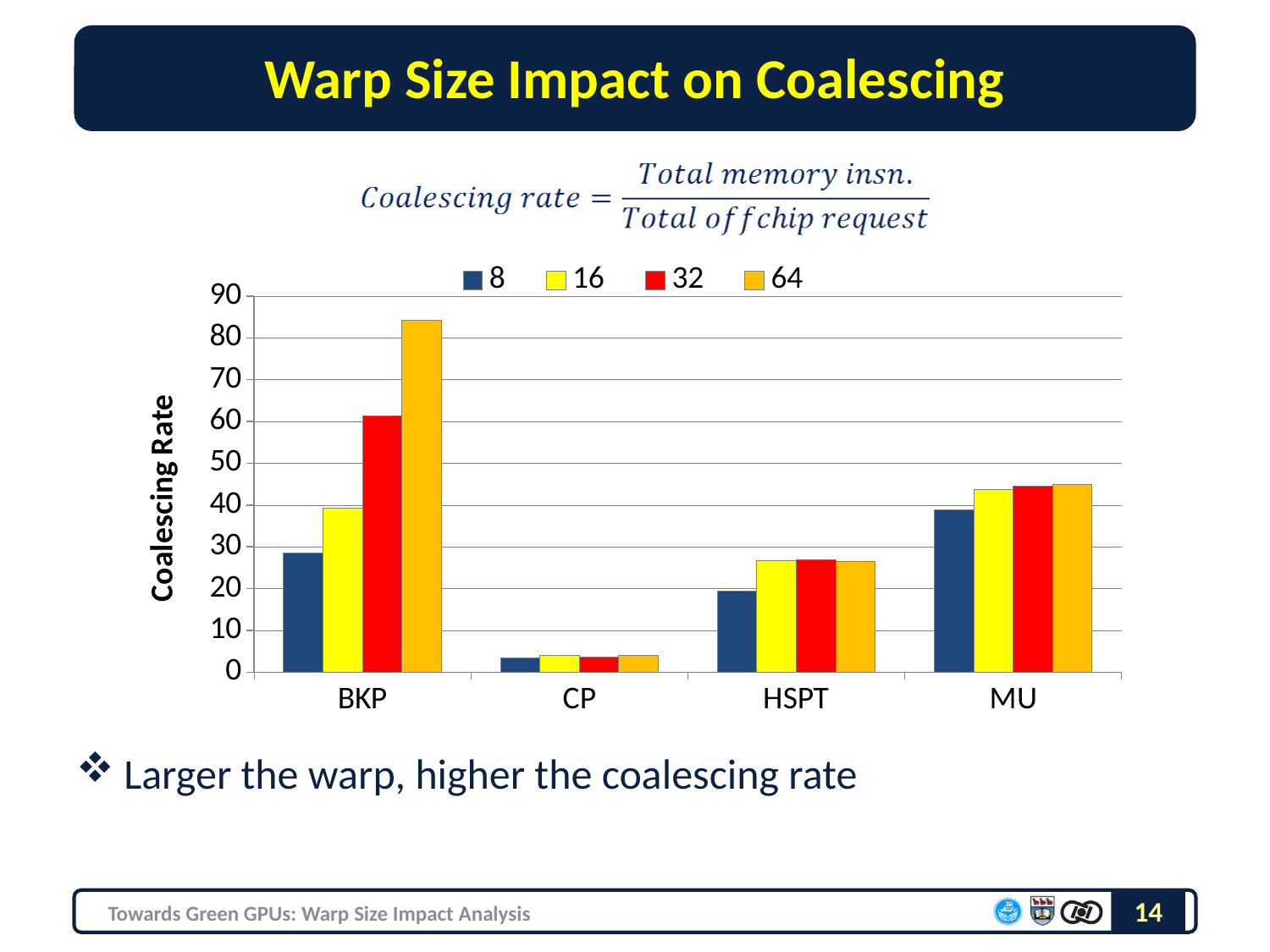
Is the coalescing rate for HSPT with warp size 8 greater or less than 30? less How many categories are shown on the x axis? 4 Is the coalescing rate for MU with warp size 8 greater or less than 30? greater Which category has the lowest coalescing rate for warp size 8? CP For warp size 64, which has the larger coalescing rate, BKP or MU? BKP Is the coalescing rate for BKP with warp size 64 greater or less than 80? greater Which category has the highest coalescing rate for warp size 64? BKP How many series does the legend list? 4 What kind of chart is shown on the slide? bar chart What is the title of the y axis? Coalescing Rate For BKP, which warp size has the larger coalescing rate, 8 or 16? 16